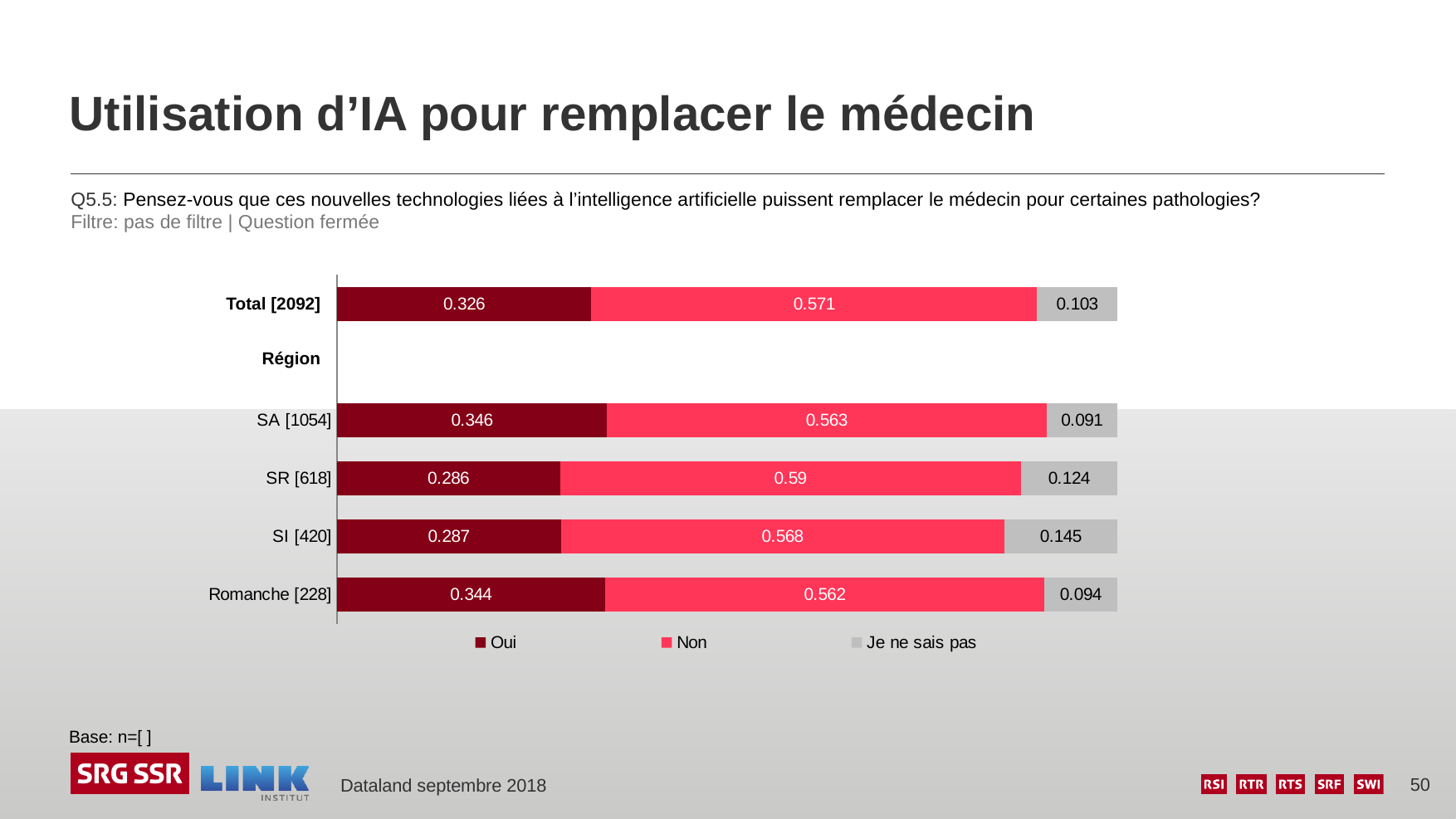
How many series does the legend list? 3 What are the three legend entries of the chart? Oui, Non, Je ne sais pas What kind of chart is shown on the slide? Stacked bar chart What is the value for Non in the SR [618] bar? 0.59 Which has a larger Oui value, SA [1054] or SR [618]? SA [1054] Which category has the highest value for Je ne sais pas? SI [420] What is the difference between the Non and Oui values in the Total [2092] bar? 0.245 What is the value for Je ne sais pas in the SI [420] bar? 0.145 What is the difference between the Je ne sais pas values for SI [420] and SA [1054]? 0.054 How many bars are plotted in the chart? 5 Which category has the highest value for Non? SR [618] What is the value for Oui in the Total [2092] bar? 0.326